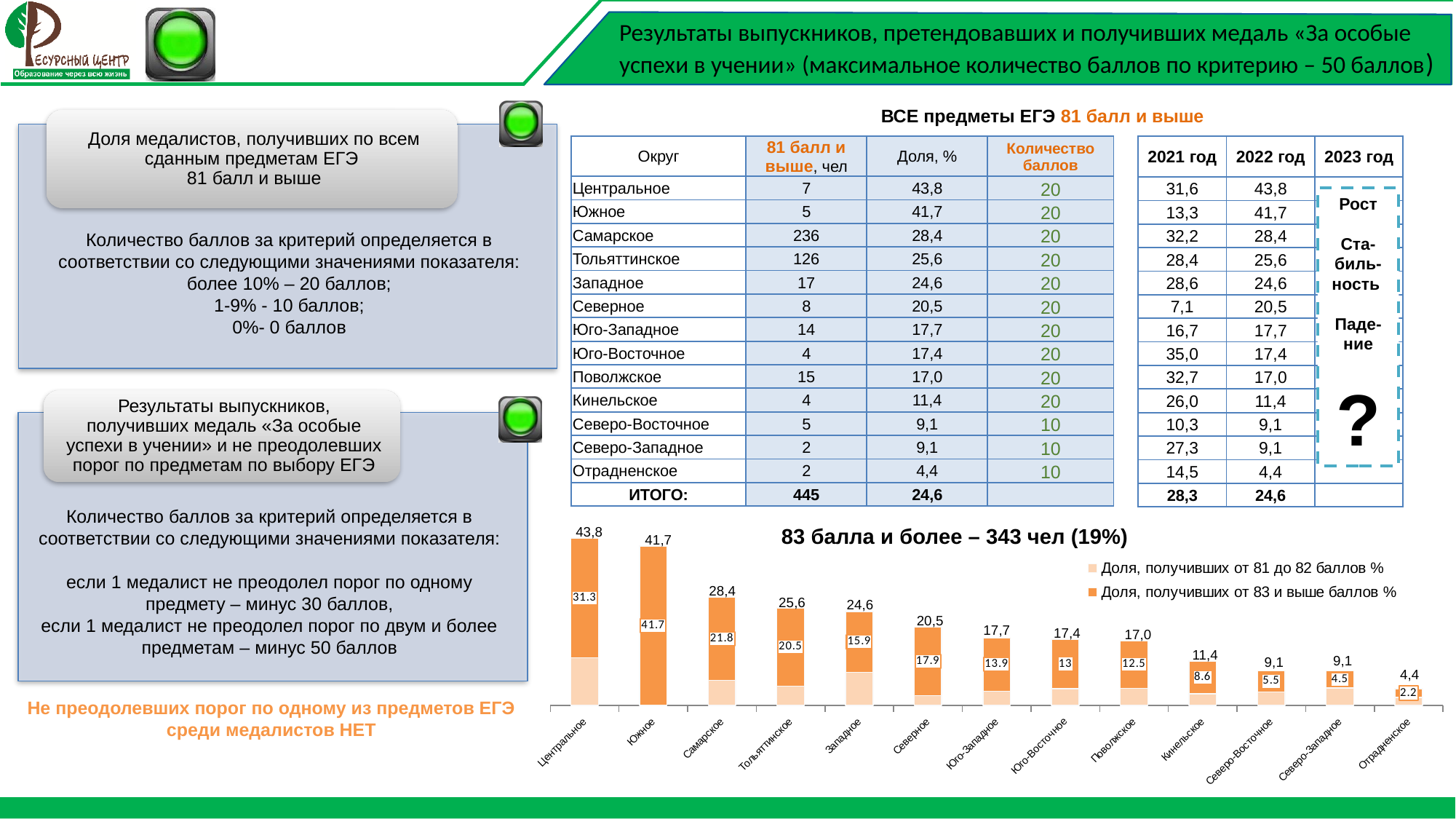
In the bar chart, what is the total value labelled above the bar for Самарское? 28,4 In the bar chart, what is the value of the 'Доля, получивших от 83 и выше баллов %' segment for Южное? 41.7 How many series does the legend of the bar chart list? 2 In the bar chart, what is the difference between the total values for Центральное and Южное? 2,1 What kind of chart is shown at the bottom right of the slide? stacked bar chart Do the total bar values in the bar chart rise or fall from left to right along the x axis? fall Which district has the lowest total bar in the bar chart? Отрадненское How many districts (categories) are shown on the x axis of the bar chart? 13 In the bar chart, what is the value of the 'Доля, получивших от 83 и выше баллов %' segment for Кинельское? 8.6 What is the title of the bar chart? 83 балла и более – 343 чел (19%) In the bar chart, which has the larger total value: Тольяттинское or Западное? Тольяттинское Which district has the highest total bar in the bar chart? Центральное